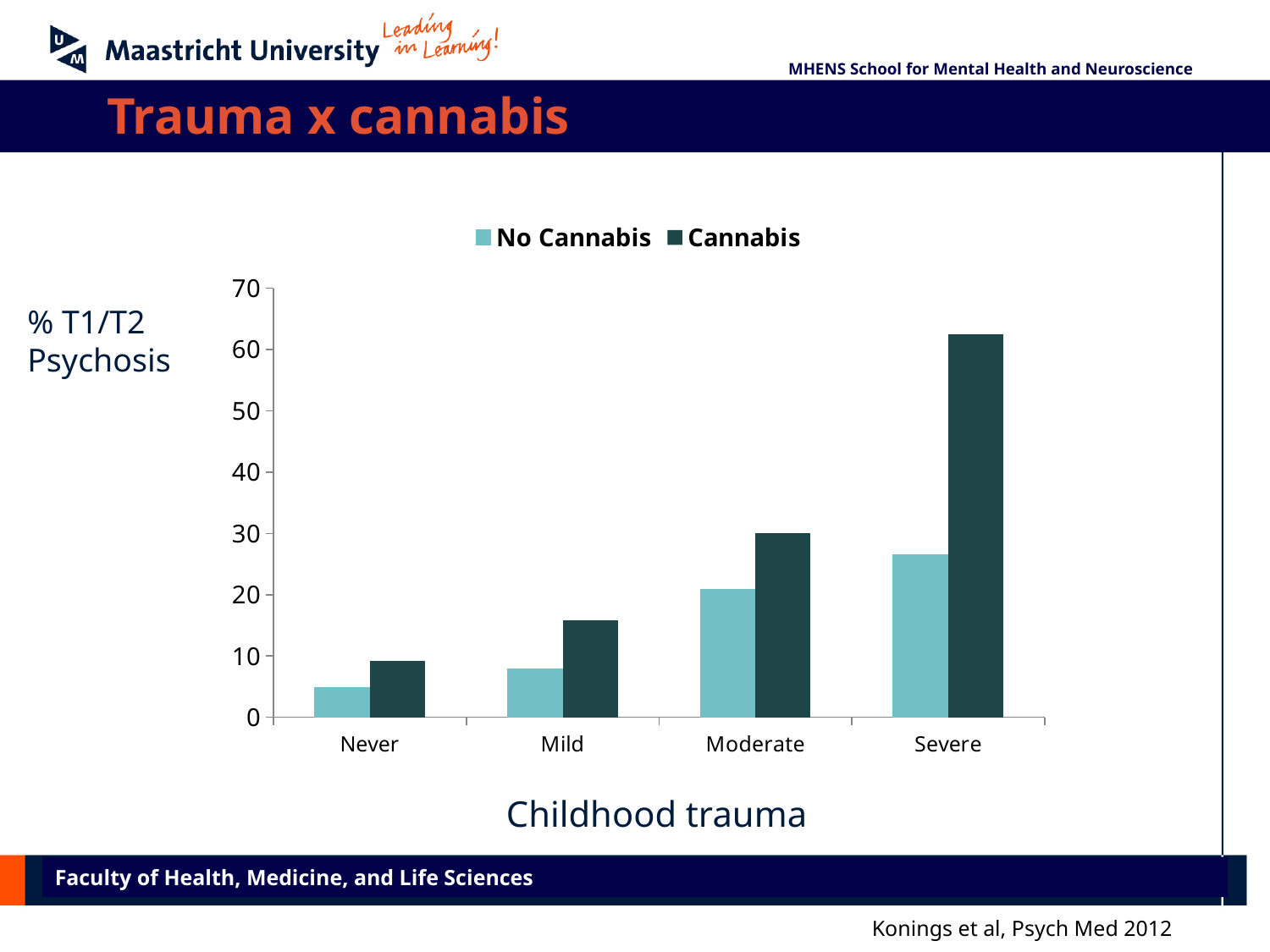
Do the Cannabis values rise or fall as childhood trauma goes from Never to Severe? rise Is the Cannabis value for Mild greater or less than 20? less How many childhood trauma categories are shown on the x axis? 4 Is the No Cannabis value for Never greater or less than 10? less For the Severe category, which series has the larger value, No Cannabis or Cannabis? Cannabis Which childhood trauma category has the highest value for the Cannabis series? Severe How many series does the legend list? 2 What is the label on the x axis of the chart? Childhood trauma Is the Cannabis value for Severe greater or less than 60? greater Which childhood trauma category has the lowest value for the No Cannabis series? Never What kind of chart is shown on the slide? bar chart